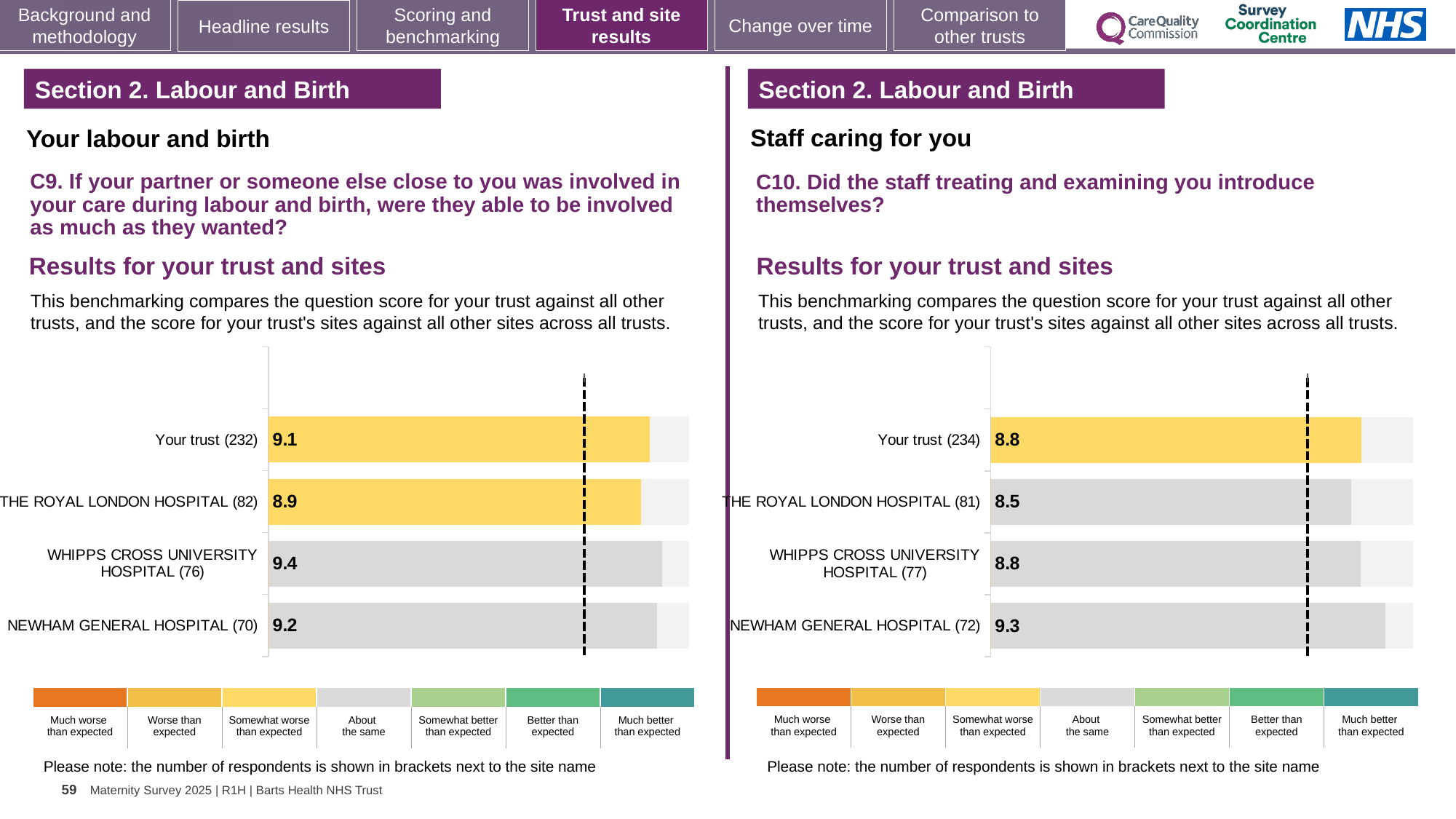
In the C9 chart on the left, what is the score for Your trust (232)? 9.1 In the C10 chart on the right, what is the score for NEWHAM GENERAL HOSPITAL (72)? 9.3 How many bars are shown in the C9 chart on the left? 4 What kind of chart is used for the C10 results on the right? Bar chart In the C9 chart on the left, which site or trust has the lowest score? THE ROYAL LONDON HOSPITAL (82) In the C9 chart on the left, which site or trust has the highest score? WHIPPS CROSS UNIVERSITY HOSPITAL (76) In the C10 chart on the right, which site or trust has the lowest score? THE ROYAL LONDON HOSPITAL (81) In the C9 chart on the left, what is the score for WHIPPS CROSS UNIVERSITY HOSPITAL (76)? 9.4 In the C10 chart on the right, what is the difference between the scores for NEWHAM GENERAL HOSPITAL (72) and THE ROYAL LONDON HOSPITAL (81)? 0.8 In the C10 chart on the right, what is the score for THE ROYAL LONDON HOSPITAL (81)? 8.5 In the C10 chart on the right, which site or trust has the highest score? NEWHAM GENERAL HOSPITAL (72) In the C9 chart on the left, what is the difference between the scores for WHIPPS CROSS UNIVERSITY HOSPITAL (76) and THE ROYAL LONDON HOSPITAL (82)? 0.5